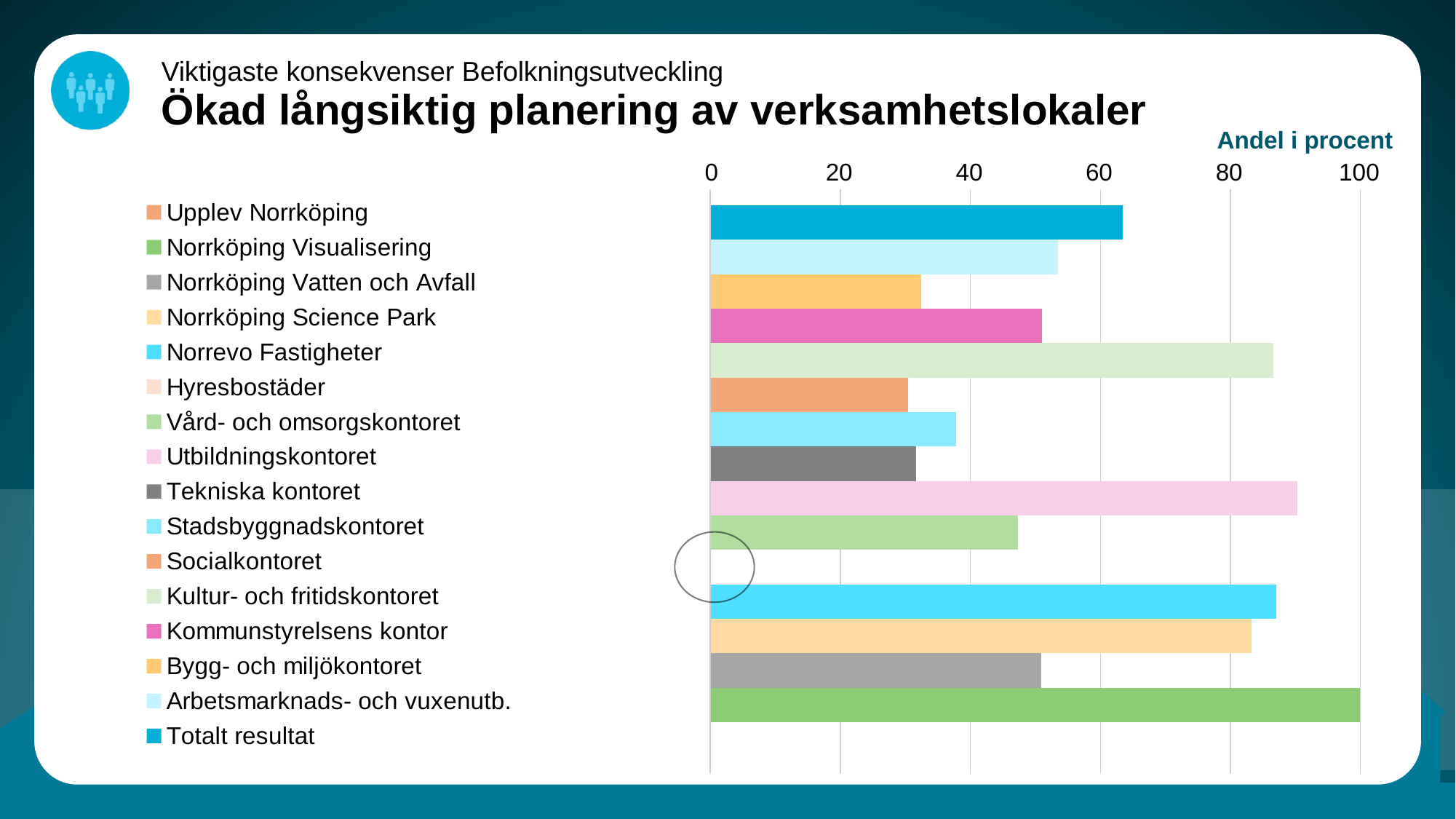
Is the value for Totalt resultat greater or less than 60? greater Is the value for Vård- och omsorgskontoret greater or less than 40? greater Which category has the highest value in the chart? Norrköping Visualisering Which is larger, the value for Kultur- och fritidskontoret or the value for Socialkontoret? Kultur- och fritidskontoret What is the value for Norrköping Visualisering? 100 Is the value for Kultur- och fritidskontoret greater or less than 80? greater What label is shown above the horizontal axis of the chart? Andel i procent How many entries does the legend list? 16 Which is larger, the value for Tekniska kontoret or the value for Utbildningskontoret? Utbildningskontoret What kind of chart is shown on the slide? bar chart